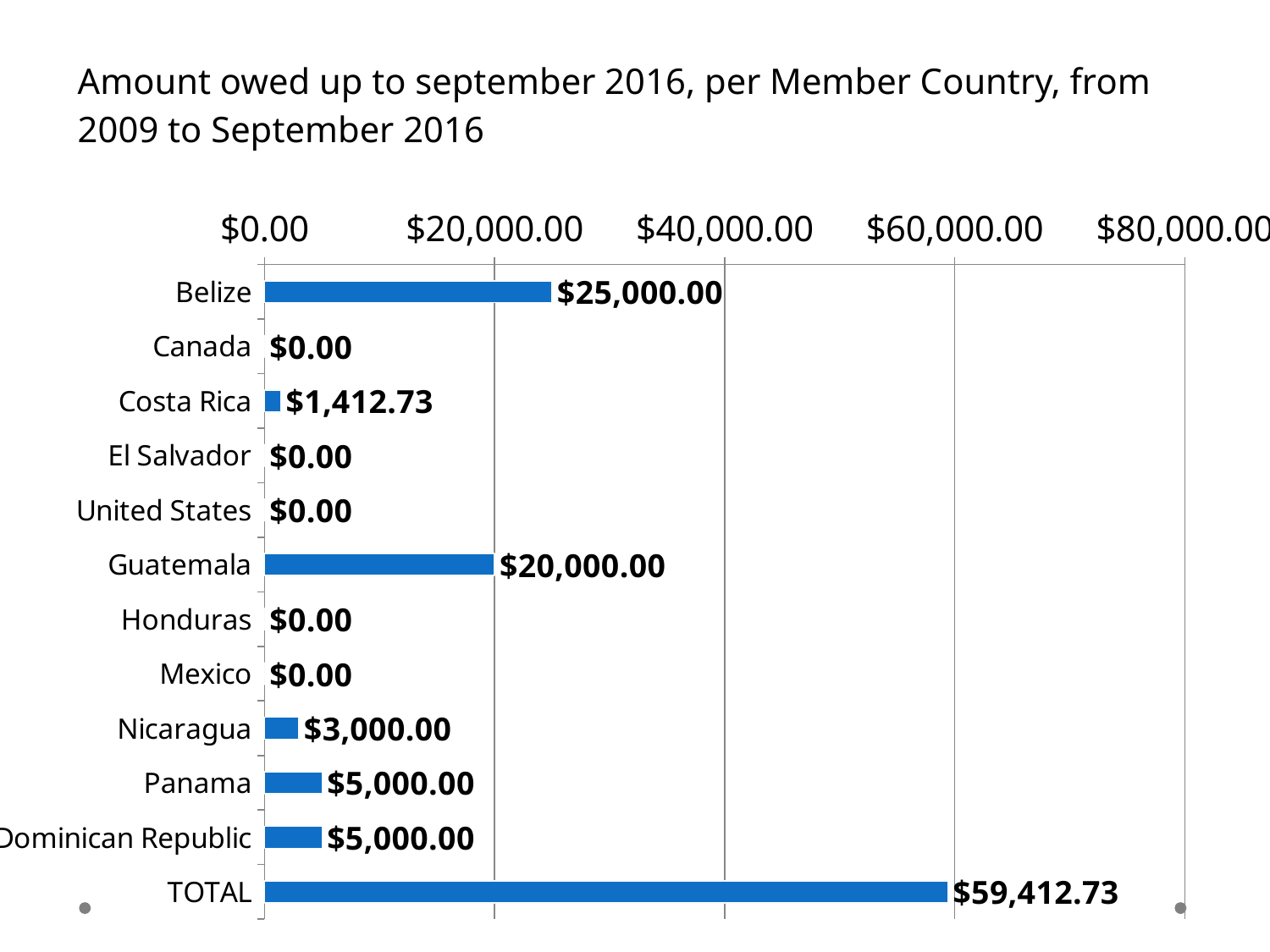
What is the amount owed by Costa Rica? $1,412.73 How many bars (categories) are shown on the chart, including TOTAL? 12 What is the difference between the amounts owed by Belize and Guatemala? $5,000.00 What is the amount owed by Nicaragua? $3,000.00 How many countries on the chart have an amount owed of $0.00? 5 Is the TOTAL bar greater or less than $40,000.00? greater What is the TOTAL amount owed shown on the chart? $59,412.73 Excluding the TOTAL bar, which country owes the highest amount? Belize What type of chart is shown on the slide? Bar chart What is the amount owed by Belize? $25,000.00 What is the amount owed by Guatemala? $20,000.00 Which owes more, Panama or Nicaragua? Panama